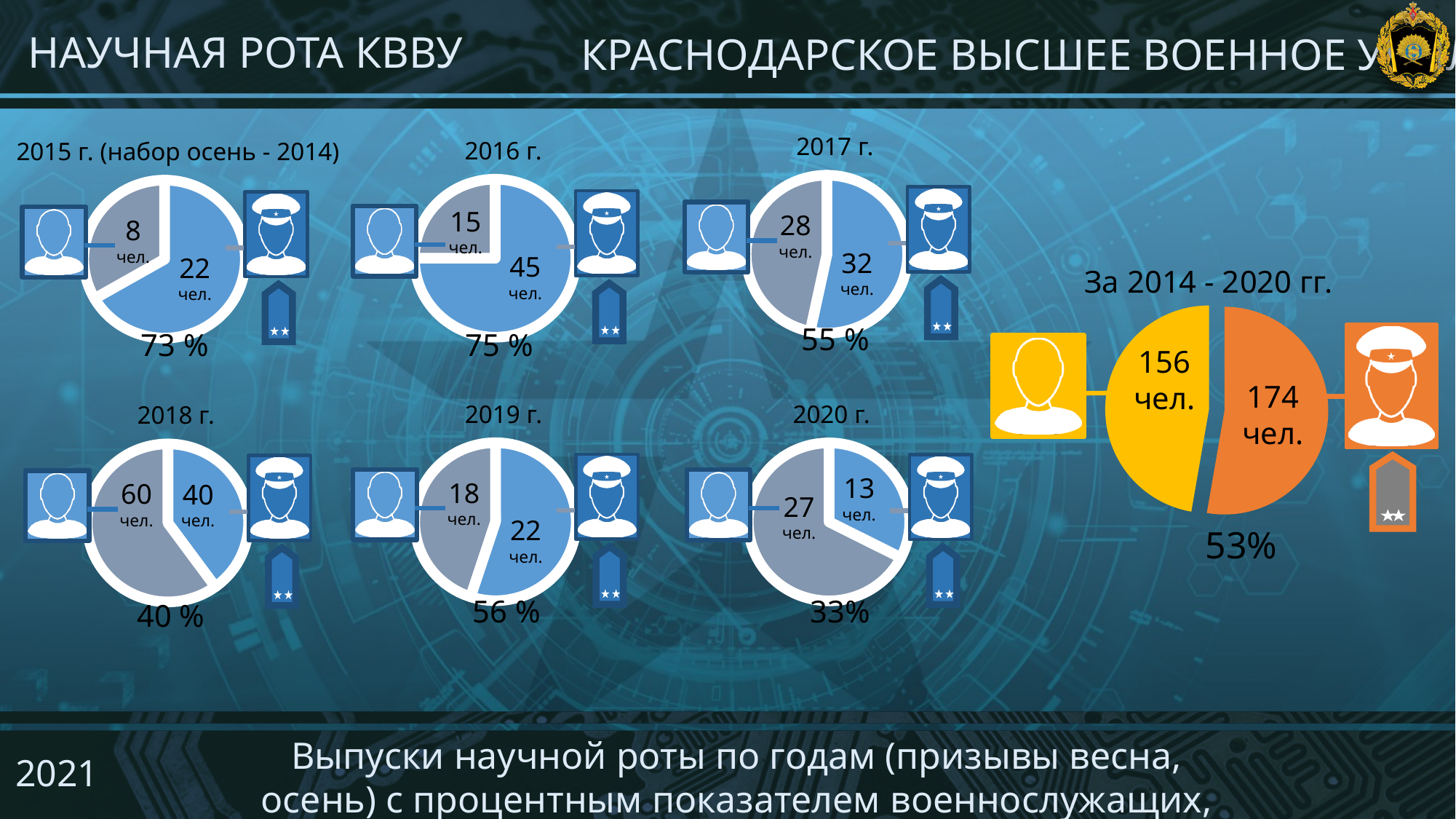
In the 2016 г. pie chart, how many people are in the grey slice? 15 чел. What colour is the larger slice in the 'За 2014 - 2020 гг.' pie chart? orange In the 'За 2014 - 2020 гг.' pie chart, how many people are in the orange slice? 174 чел. In the 2019 г. pie chart, what is the difference between the blue slice (22 чел.) and the grey slice (18 чел.)? 4 чел. How many pie charts are on the slide? 7 What kind of chart is used for each year on the slide? pie chart What is the total number of people shown in the 2020 г. pie chart? 40 чел. In the 2018 г. pie chart, which slice is larger, the grey one (60 чел.) or the blue one (40 чел.)? the grey one (60 чел.) What percentage is printed below the 2017 г. pie chart? 55 % What percentage is printed below the 'За 2014 - 2020 гг.' pie chart? 53% In the 2015 г. pie chart, how many people are in the blue (officer) slice? 22 чел. Which year's pie chart has the lowest percentage printed below it? 2020 г. (33%)